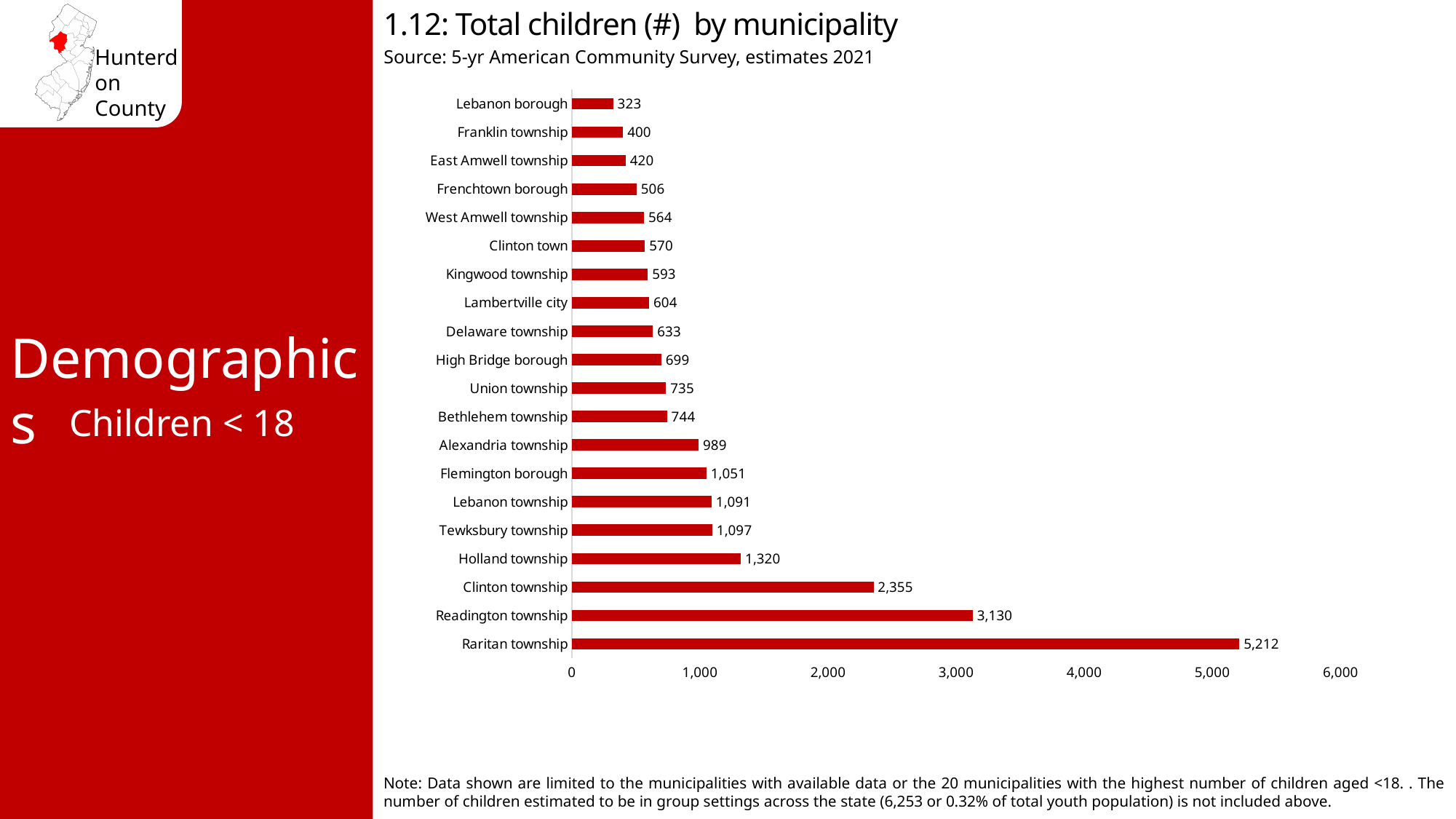
What is the source of the data shown in the chart? 5-yr American Community Survey, estimates 2021 How many municipalities are shown in the chart? 20 Is the value for Alexandria township greater or less than 1,000? less What kind of chart is shown on the slide? bar chart Which has more children, Holland township or Tewksbury township? Holland township What is the total number of children in Flemington borough? 1,051 What is the difference in the number of children between Readington township and Clinton township? 775 What is the total number of children in Clinton town? 570 What is the total number of children in Raritan township? 5,212 What is the difference in the number of children between Franklin township and Lebanon borough? 77 Which municipality has the highest number of children? Raritan township Which municipality has the lowest number of children? Lebanon borough